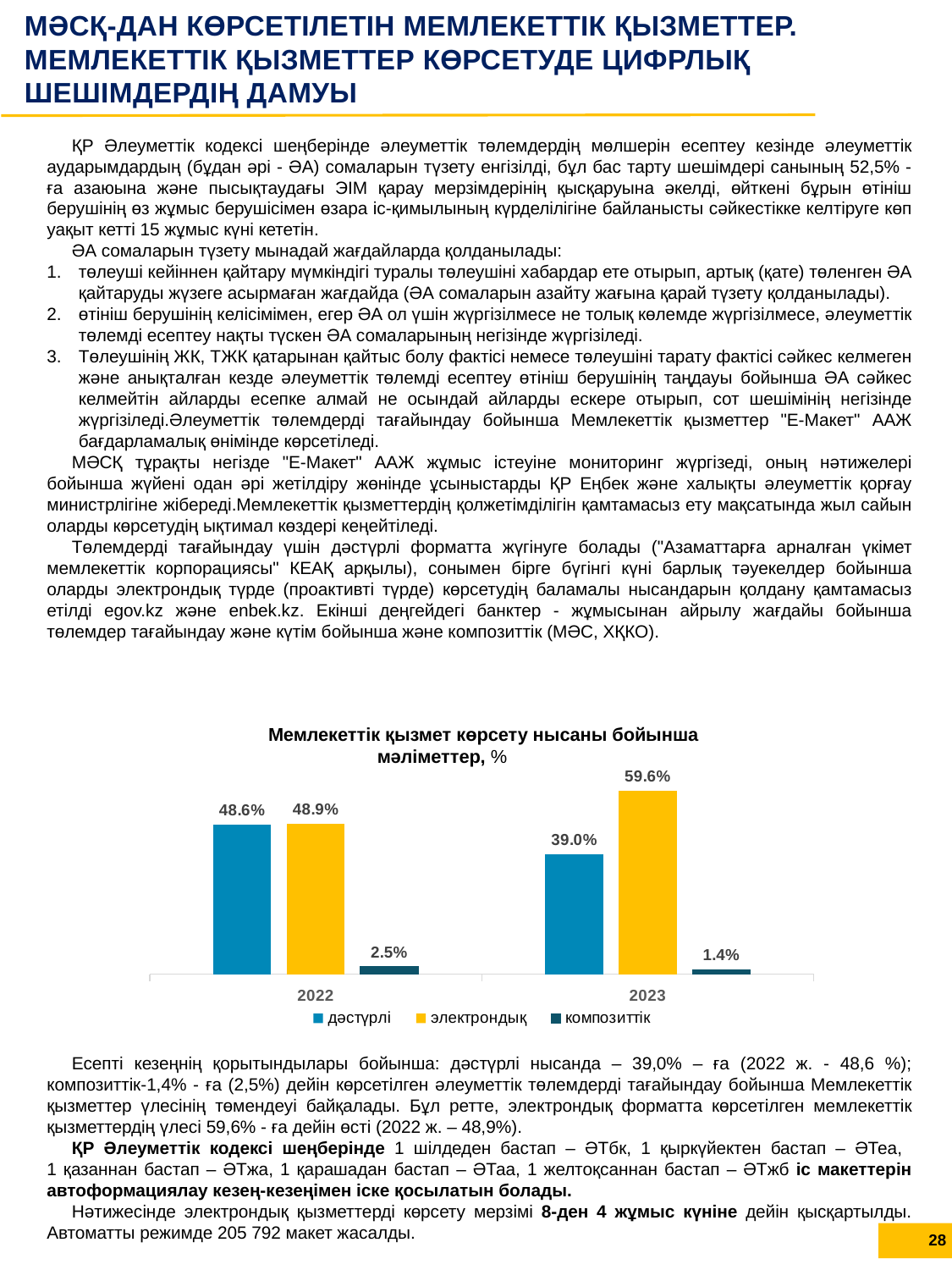
How many series does the legend list? 3 Does the композиттік value rise or fall from 2022 to 2023? fall What is the difference between the электрондық values for 2023 and 2022? 10.7% What type of chart is shown on the slide? bar chart How many categories are shown on the x axis? 2 Which series has the highest value in 2023? электрондық What is the value for электрондық in 2023? 59.6% What is the value for дәстүрлі in 2022? 48.6% What is the value for дәстүрлі in 2023? 39.0% What is the value for композиттік in 2022? 2.5% Which series has the lowest value in 2022? композиттік Which is larger: the дәстүрлі value in 2022 or in 2023? 2022